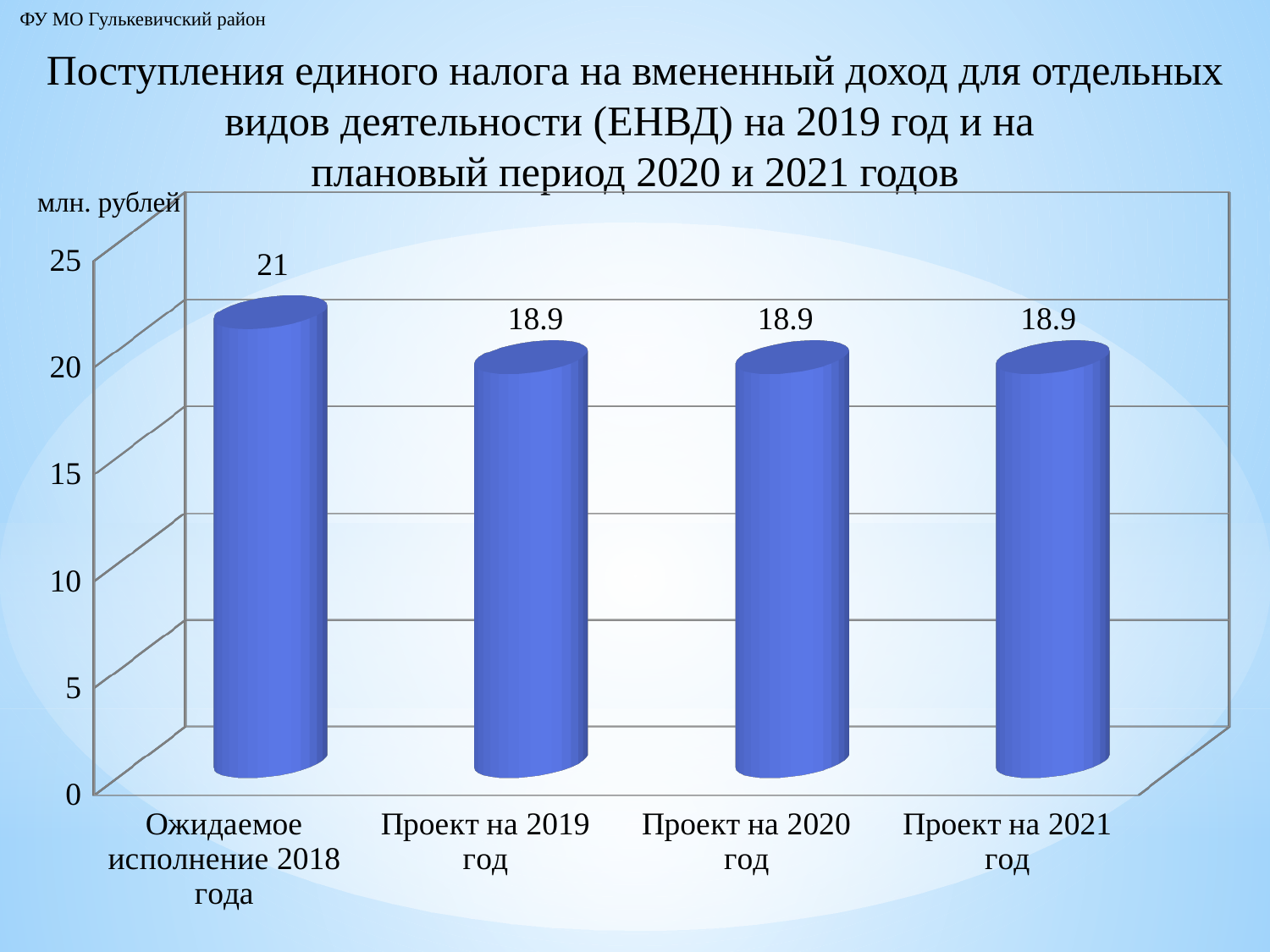
How many categories are shown on the chart? 4 What kind of chart is shown on the slide? bar chart Do the values rise or fall from the first category to the last? fall What unit is shown on the vertical axis of the chart? млн. рублей Which category has the highest value? Ожидаемое исполнение 2018 года What is the value for "Проект на 2021 год"? 18.9 What is the value for "Ожидаемое исполнение 2018 года"? 21 Which is larger: the value for "Ожидаемое исполнение 2018 года" or the value for "Проект на 2019 год"? Ожидаемое исполнение 2018 года What is the difference between the value for "Ожидаемое исполнение 2018 года" and the value for "Проект на 2020 год"? 2.1 Is the value for "Ожидаемое исполнение 2018 года" greater or less than 20? greater What is the value for "Проект на 2019 год"? 18.9 Is the value for "Проект на 2020 год" greater or less than 20? less